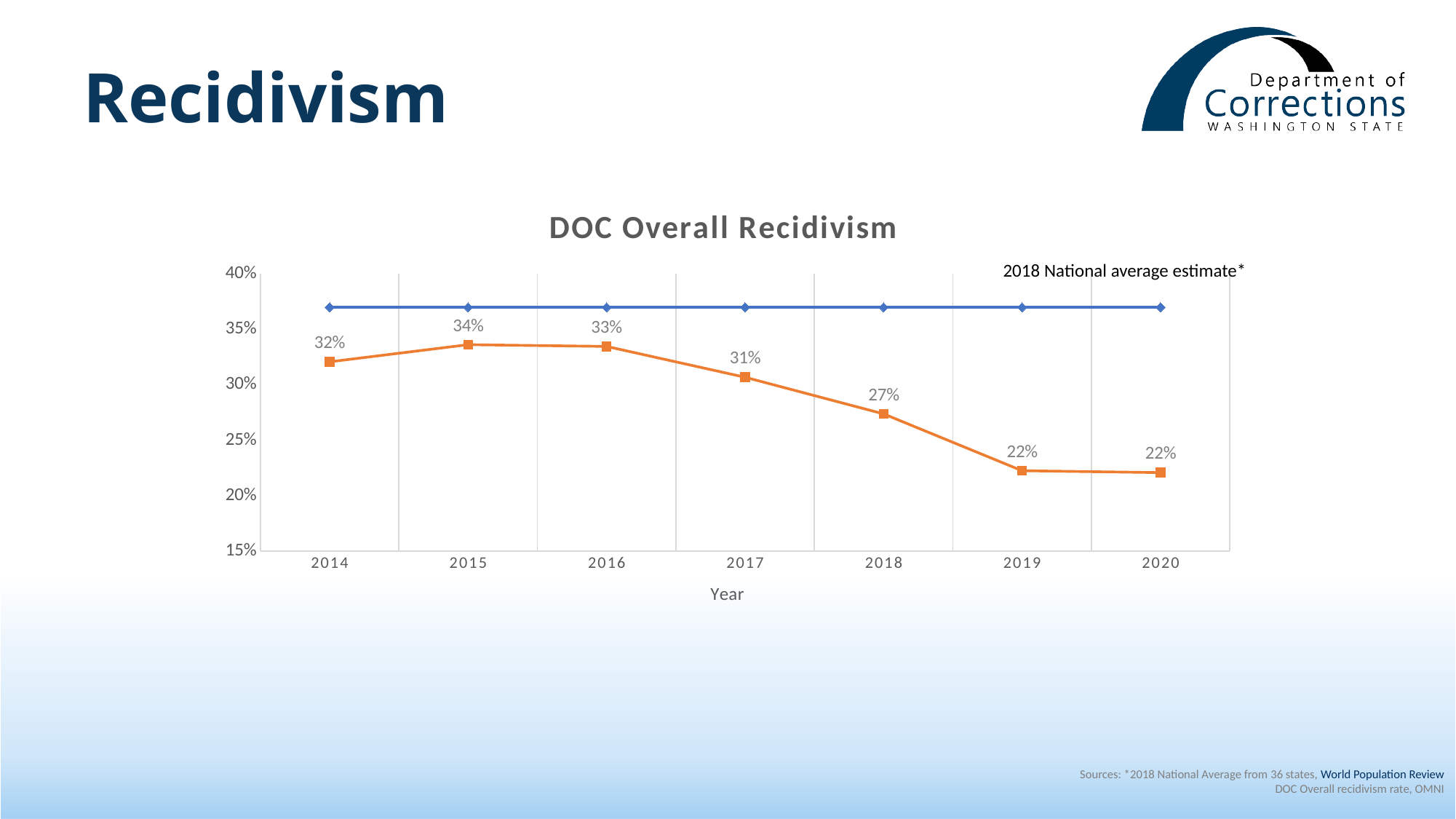
What is the DOC overall recidivism rate for 2020? 22% What is the difference between the DOC recidivism rate in 2015 and in 2019? 12% Which year has the higher DOC recidivism rate, 2016 or 2018? 2016 What is the DOC overall recidivism rate for 2017? 31% What is the title of the chart? DOC Overall Recidivism Which year has the highest DOC overall recidivism rate? 2015 Is the 2018 National average estimate line greater or less than 35%? greater Does the DOC overall recidivism rate rise or fall from 2016 to 2019? Fall How many years are shown on the x axis of the chart? 7 What is the label of the x axis? Year What is the DOC overall recidivism rate for 2014? 32% What kind of chart is shown on the slide? Line chart